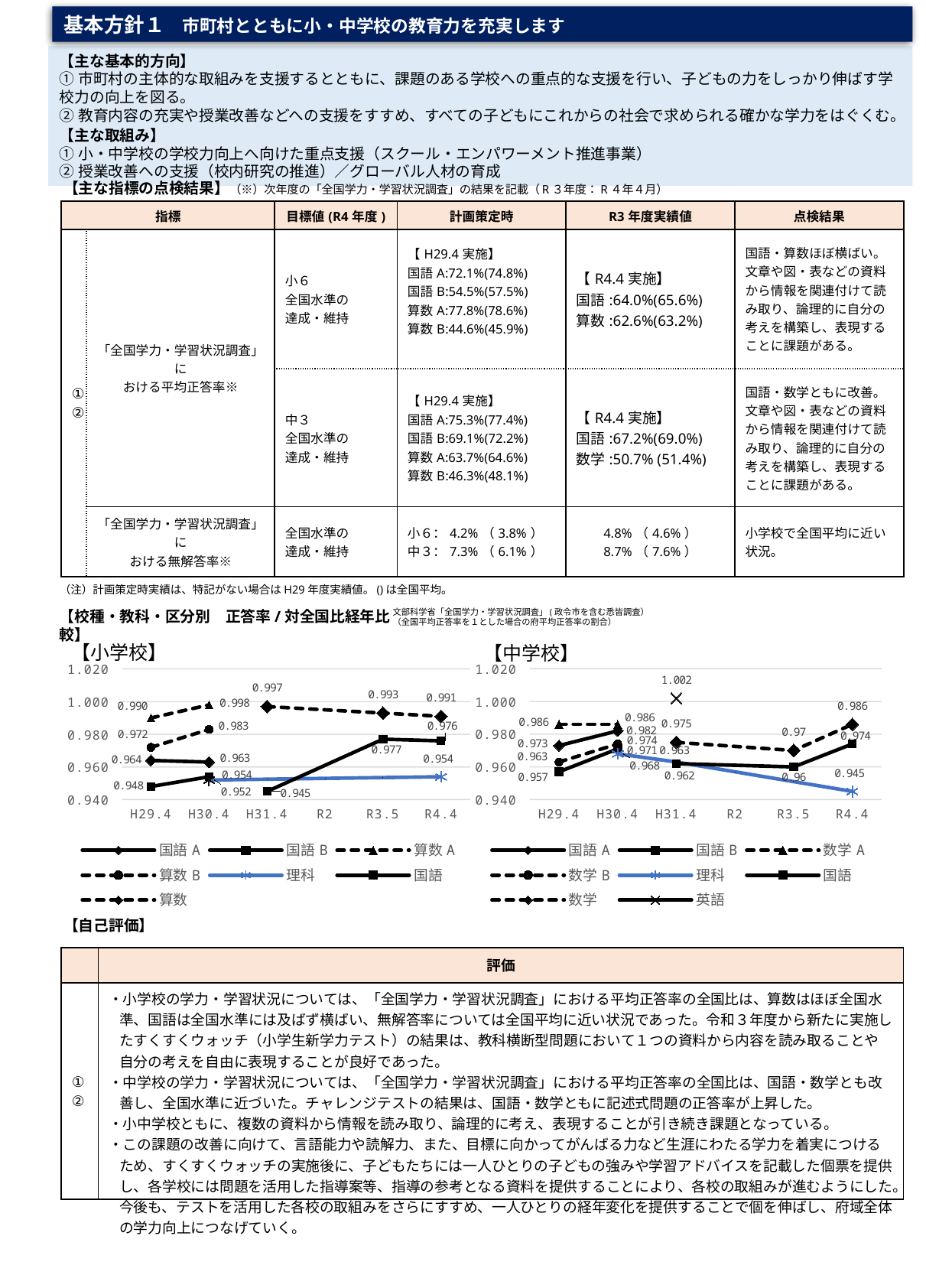
How many points are on the x axis of the 【中学校】 chart? 6 In the 【小学校】 chart, what is the difference between 算数 and 国語 at R4.4? 0.015 How many series does the legend of the 【小学校】 chart list? 7 In the 【小学校】 chart, which is larger at R4.4, 算数 or 国語? 算数 In the 【小学校】 chart, what is the value for 算数 at R4.4? 0.991 In the 【中学校】 chart, what is the value for 理科 at R4.4? 0.945 In the 【中学校】 chart, what is the value for 英語 at H31.4? 1.002 How many series does the legend of the 【中学校】 chart list? 8 In the 【小学校】 chart, what is the value for 国語 B at H29.4? 0.948 In the 【小学校】 chart, what is the value for 国語 at R4.4? 0.976 In the 【中学校】 chart, what is the value for 数学 at R4.4? 0.986 What kind of chart is the 【小学校】 chart? line chart